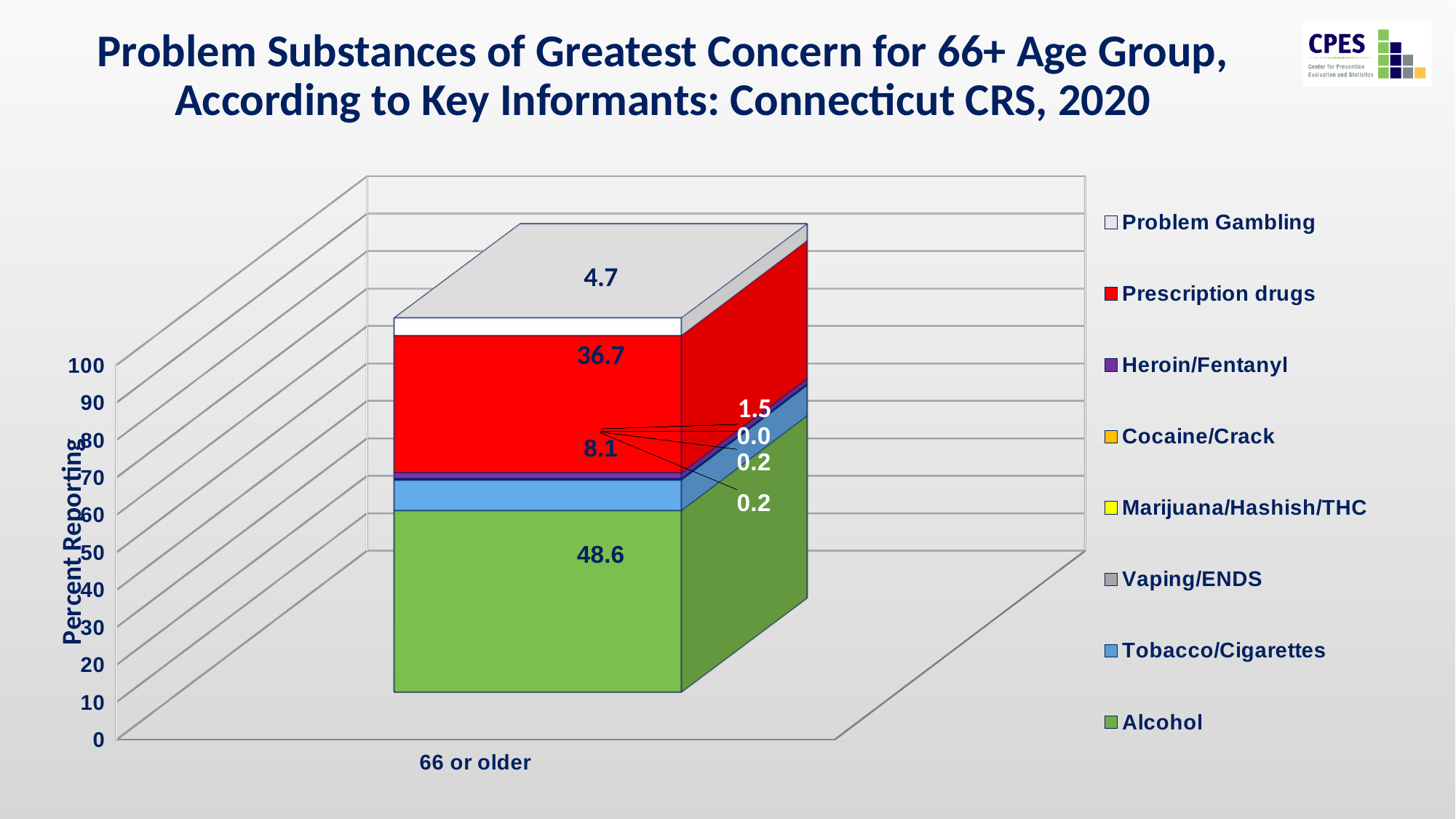
Which substance has the largest segment in the 66 or older bar? Alcohol What is the value for Tobacco/Cigarettes in the 66 or older bar? 8.1 What is the value for Problem Gambling in the 66 or older bar? 4.7 What is the label of the single category on the x axis? 66 or older What percent of key informants reported Alcohol as a problem substance of greatest concern for the 66 or older age group? 48.6 What kind of chart is shown on the slide? Stacked bar chart How much larger is the Prescription drugs value than the Tobacco/Cigarettes value? 28.6 How many age-group categories are plotted on the x axis? 1 How many series does the legend list? 8 What is the difference between the Alcohol value and the Prescription drugs value? 11.9 Which is larger for the 66 or older group: Alcohol or Prescription drugs? Alcohol What is the value for Prescription drugs in the 66 or older bar? 36.7